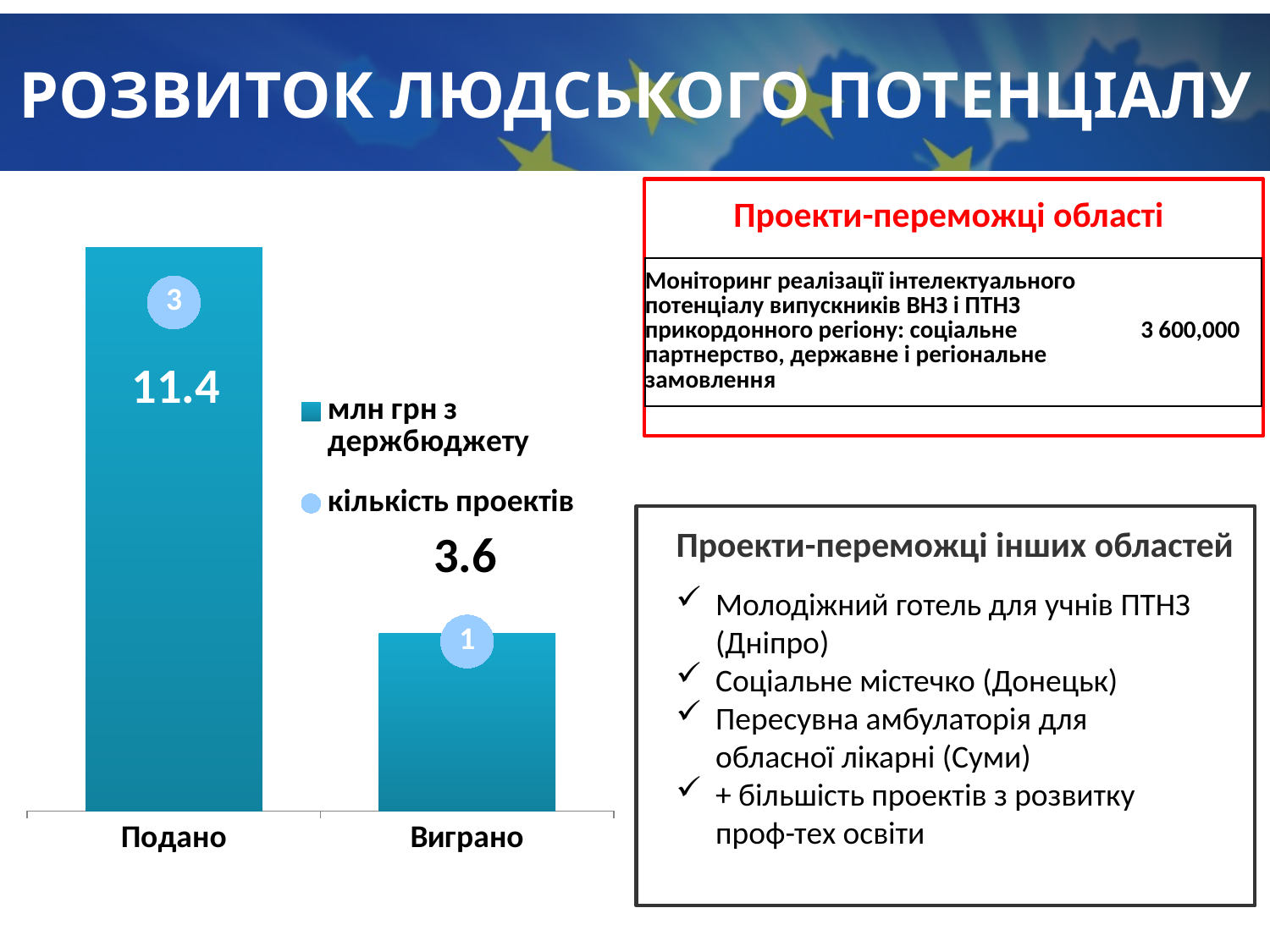
Which is larger: the 'млн грн з держбюджету' value for 'Подано' or for 'Виграно'? Подано What is the value of 'млн грн з держбюджету' for 'Подано'? 11.4 What kind of chart is shown on the slide? bar chart What is the difference between the 'кількість проектів' values for 'Подано' and 'Виграно'? 2 Which category has the highest value for 'млн грн з держбюджету'? Подано What is the value of 'млн грн з держбюджету' for 'Виграно'? 3.6 What is the difference between the 'млн грн з держбюджету' values for 'Подано' and 'Виграно'? 7.8 What is the value of 'кількість проектів' for 'Подано'? 3 What is the value of 'кількість проектів' for 'Виграно'? 1 How many categories are shown on the x axis of the chart? 2 How many series does the chart legend list? 2 Which category has the lowest value for 'кількість проектів'? Виграно